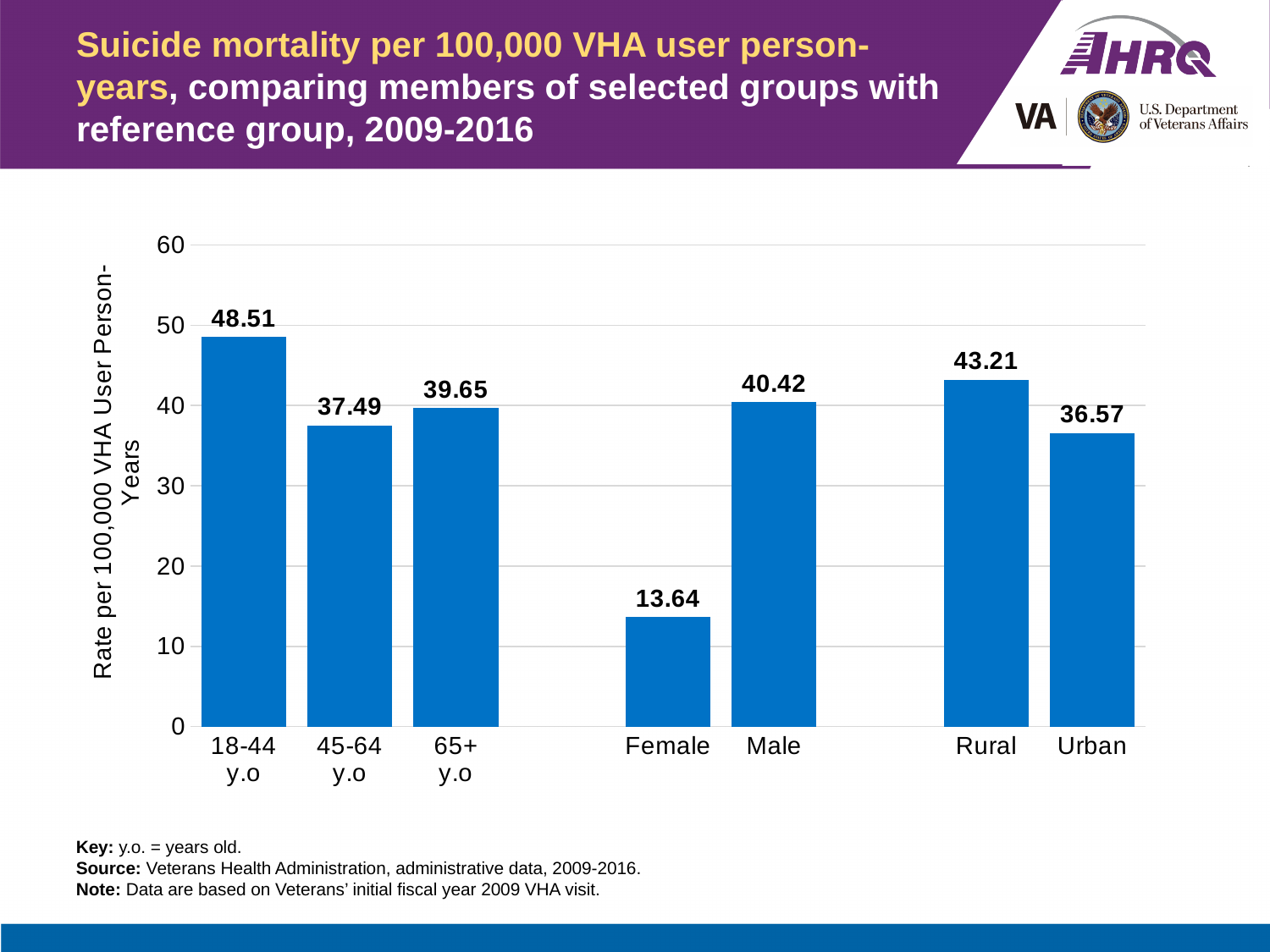
Which group has the highest suicide mortality rate? 18-44 y.o What is the suicide mortality rate for the Rural group? 43.21 How many groups are shown in the chart? 7 What is the difference between the Rural and Urban suicide mortality rates? 6.64 What is the suicide mortality rate for Female Veterans? 13.64 Is the value for Urban greater or less than 40? less What is the label of the vertical axis? Rate per 100,000 VHA User Person-Years What is the suicide mortality rate for the 18-44 y.o group? 48.51 Which group has the lowest suicide mortality rate? Female What is the difference between the Male and Female suicide mortality rates? 26.78 Which has a higher suicide mortality rate, the 45-64 y.o group or the 65+ y.o group? 65+ y.o What kind of chart is shown on the slide? Bar chart